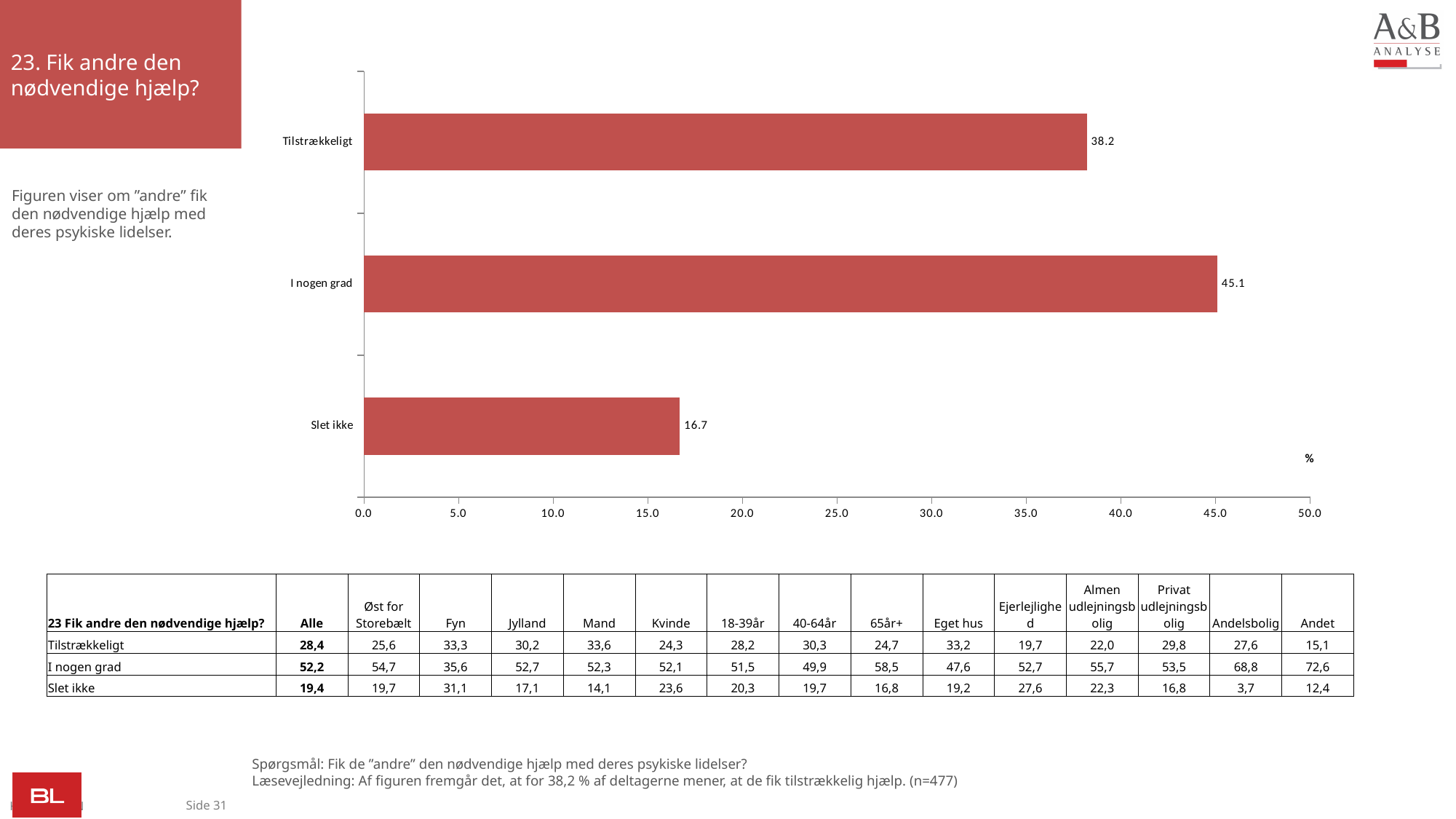
Which category has the lowest value in the chart? Slet ikke What value is shown for "I nogen grad" in the chart? 45.1 What is the maximum value shown on the chart's horizontal axis? 50.0 Which is larger, the value for "Tilstrækkeligt" or the value for "Slet ikke"? Tilstrækkeligt What value is shown for "Tilstrækkeligt" in the chart? 38.2 What is the difference between the values for "I nogen grad" and "Tilstrækkeligt"? 6.9 How many categories are shown in the chart? 3 What kind of chart is shown on the slide? bar chart Which category has the highest value in the chart? I nogen grad What value is shown for "Slet ikke" in the chart? 16.7 What is the difference between the values for "Tilstrækkeligt" and "Slet ikke"? 21.5 Is the value for "I nogen grad" greater or less than 40.0? greater